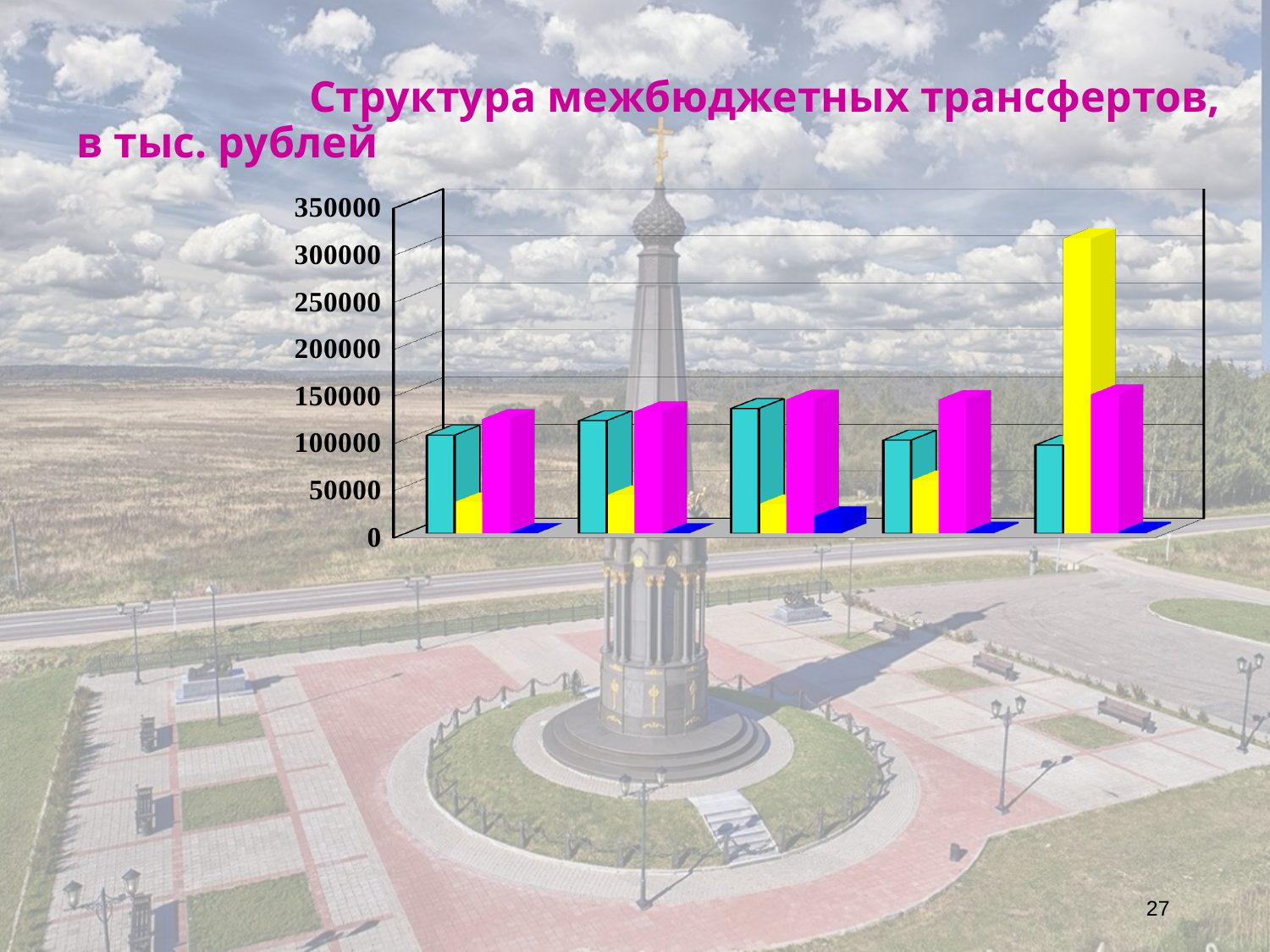
Which colour series has the shortest bars across all groups? blue How many groups of bars are plotted along the x axis? 5 What kind of chart is shown on the slide? bar chart Is the value of the yellow bar in the rightmost group greater or less than 250000? greater What is the highest value shown on the vertical axis? 350000 Is the value of the cyan bar in the third group greater or less than 100000? greater How many differently coloured bar series appear in each group? 4 In the rightmost group, which is larger: the yellow bar or the magenta bar? the yellow bar Is the value of the magenta bar in the first (leftmost) group greater or less than 150000? less What colour is the tallest bar on the chart? yellow What is the title of the chart? Структура межбюджетных трансфертов, в тыс. рублей Which group of bars contains the tallest bar on the chart? the rightmost (fifth) group